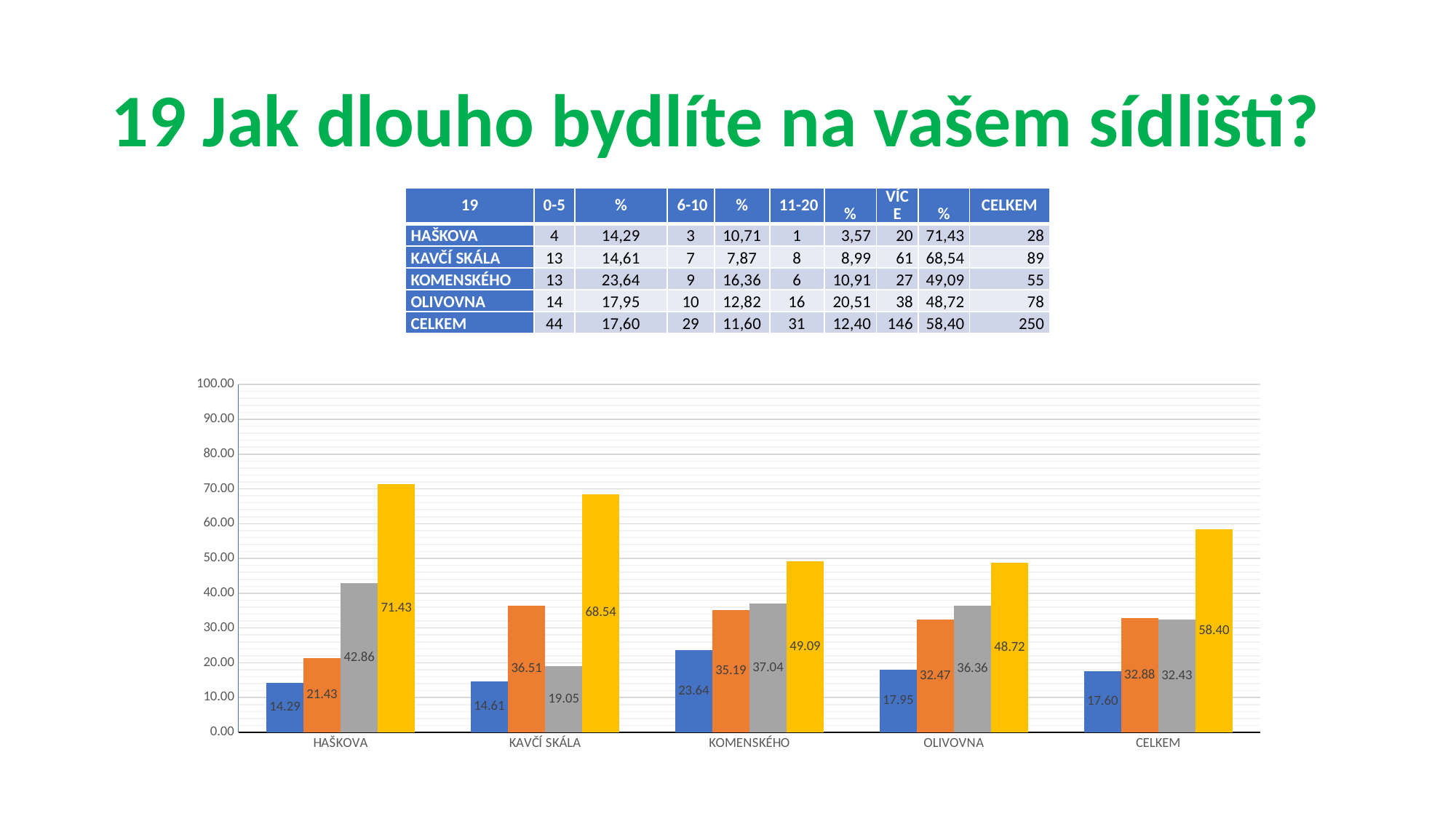
What is the value of the gray bar for KAVČÍ SKÁLA? 19.05 What is the difference between the yellow bar values for HAŠKOVA and KAVČÍ SKÁLA? 2.89 How many bars are shown for each category in the chart? 4 Which is larger for OLIVOVNA, the orange bar or the gray bar? the gray bar What kind of chart is shown on the slide? bar chart What is the value of the orange bar for CELKEM? 32.88 What is the value of the yellow bar for HAŠKOVA? 71.43 What is the value of the blue bar for KOMENSKÉHO? 23.64 Which category has the highest yellow bar? HAŠKOVA How many categories are shown on the x axis of the chart? 5 Which category has the lowest blue bar? HAŠKOVA Is the value of the yellow bar for CELKEM greater or less than 50.00? greater